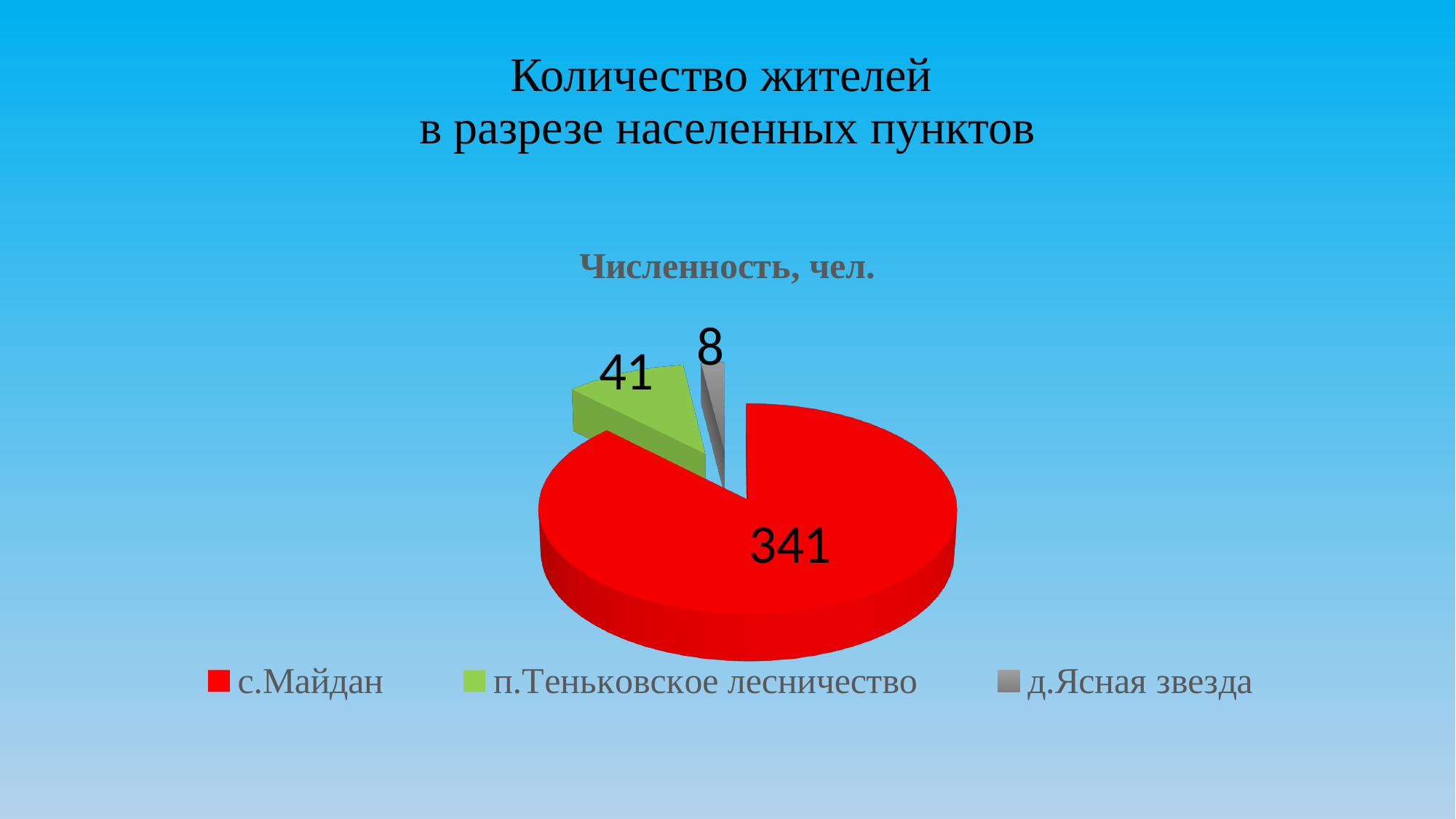
What is the total of all slices in the pie chart? 390 What is the title of the chart? Численность, чел. What is the difference between the values for п.Теньковское лесничество and д.Ясная звезда? 33 What is the value for п.Теньковское лесничество? 41 Which is larger, the value for п.Теньковское лесничество or д.Ясная звезда? п.Теньковское лесничество What is the difference between the values for с.Майдан and п.Теньковское лесничество? 300 What type of chart is shown on the slide? Pie chart How many slices does the pie chart have? 3 What is the value for с.Майдан? 341 Which settlement has the largest number of residents? с.Майдан What is the value for д.Ясная звезда? 8 Which settlement has the smallest number of residents? д.Ясная звезда